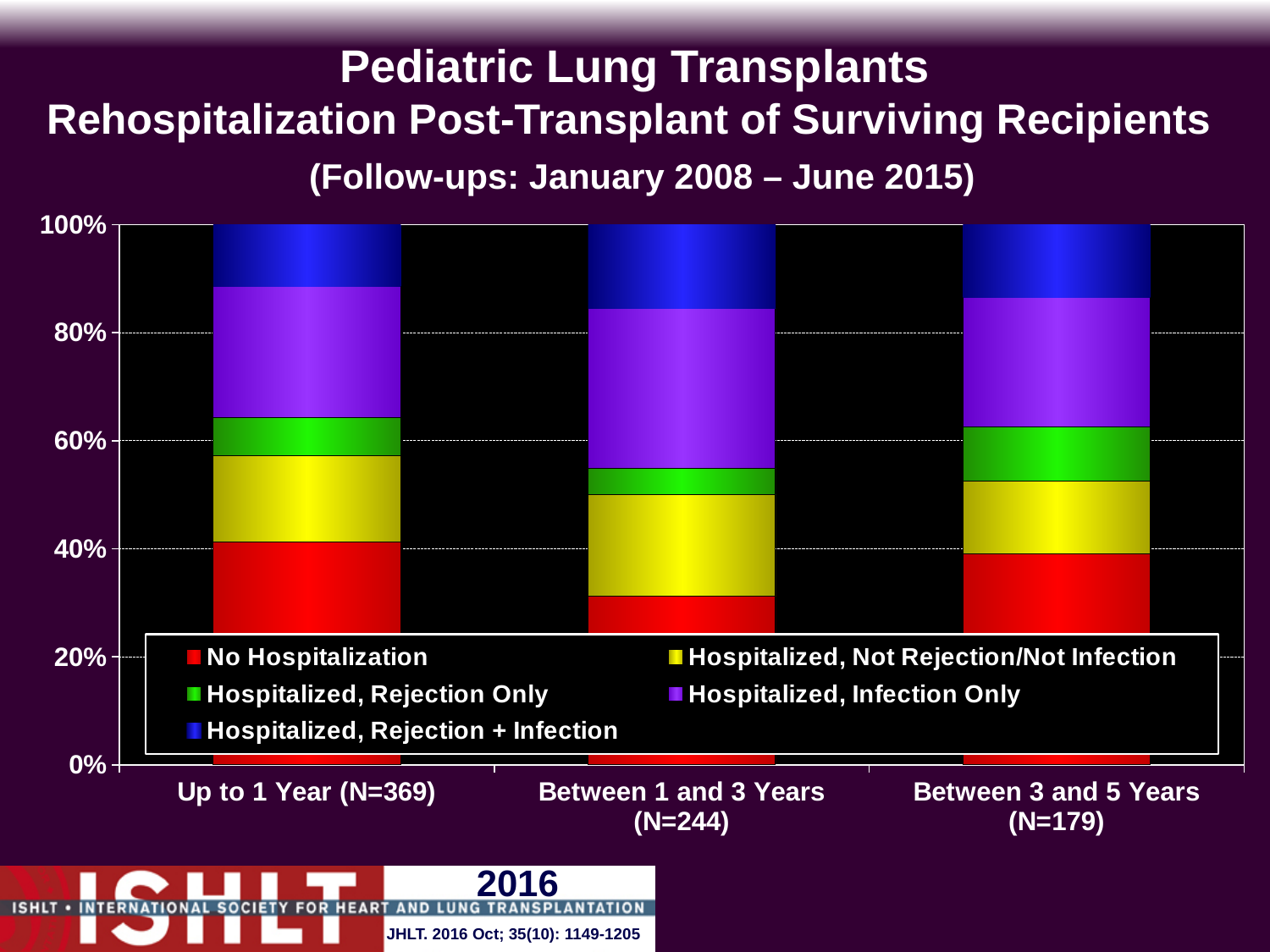
Which follow-up category has the largest Hospitalized, Rejection Only share? Between 3 and 5 Years (N=179) Is the No Hospitalization share for Up to 1 Year (N=369) greater or less than 20%? greater Which follow-up category has the smallest No Hospitalization share? Between 1 and 3 Years (N=244) Is the No Hospitalization share for Between 1 and 3 Years (N=244) greater or less than 40%? less What follow-up period is given in the chart's subtitle? January 2008 – June 2015 Which is larger, the No Hospitalization share for Up to 1 Year (N=369) or for Between 1 and 3 Years (N=244)? Up to 1 Year (N=369) How many series does the legend list? 5 Which follow-up category has the largest Hospitalized, Infection Only share? Between 1 and 3 Years (N=244) How many follow-up categories are shown on the x axis? 3 What colour represents Hospitalized, Rejection + Infection in the legend? Blue What is the total height of the stacked bar for Up to 1 Year (N=369)? 100% What kind of chart is shown on the slide? Stacked bar chart